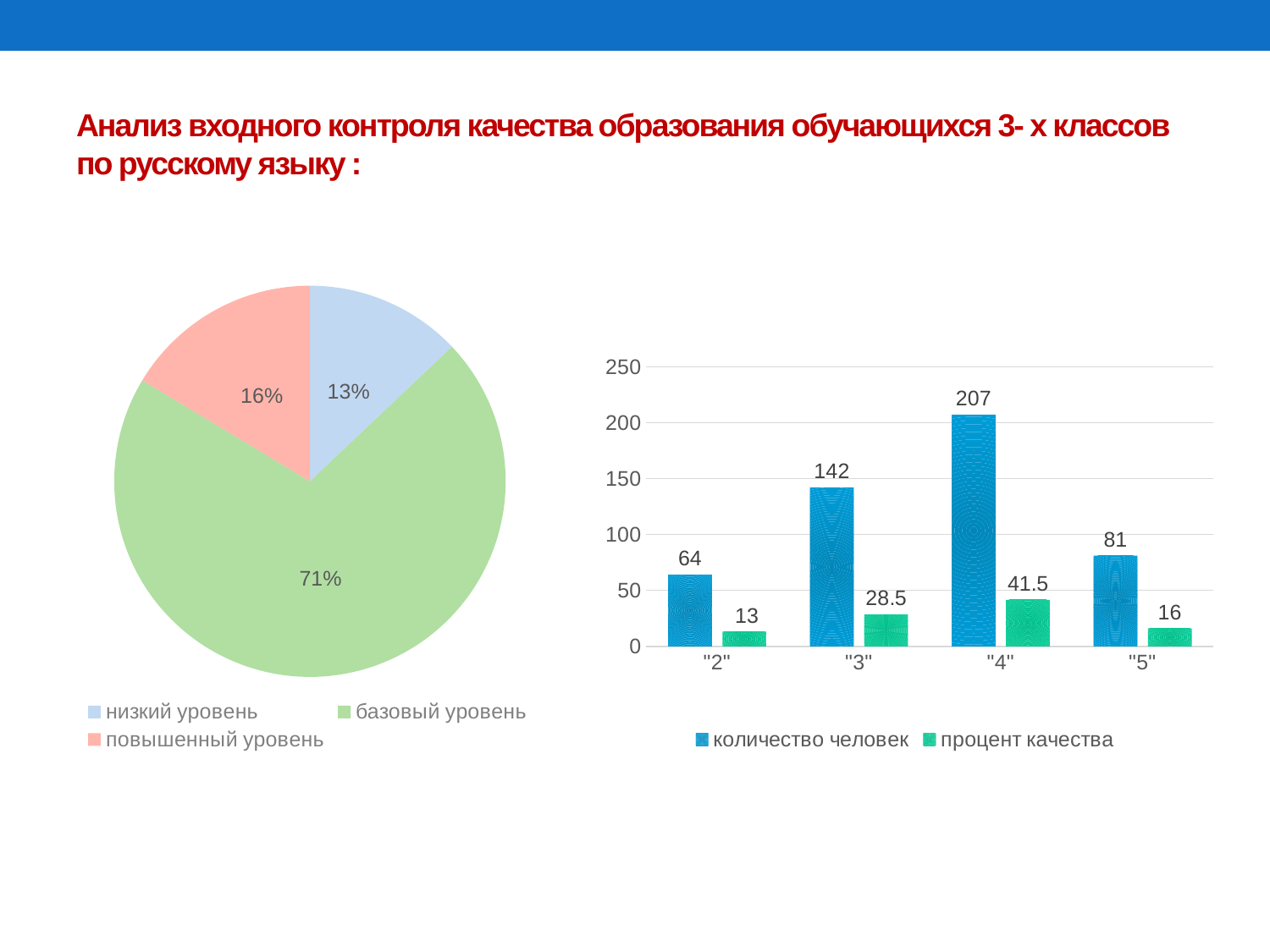
In the pie chart on the left, which level has the smallest share? низкий уровень In the bar chart on the right, what is the difference in "количество человек" between "4" and "3"? 65 In the bar chart on the right, how many series does the legend list? 2 In the pie chart on the left, how many slices are there? 3 In the bar chart on the right, which category has the lowest "процент качества"? "2" In the bar chart on the right, what is the value of "процент качества" for "3"? 28.5 In the pie chart on the left, which level has the largest share? базовый уровень In the pie chart on the left, what share does "низкий уровень" have? 13% In the pie chart on the left, what share does "базовый уровень" have? 71% What kind of chart is the chart on the right? bar chart In the bar chart on the right, which category has the highest "количество человек"? "4" In the bar chart on the right, what is the value of "количество человек" for "4"? 207